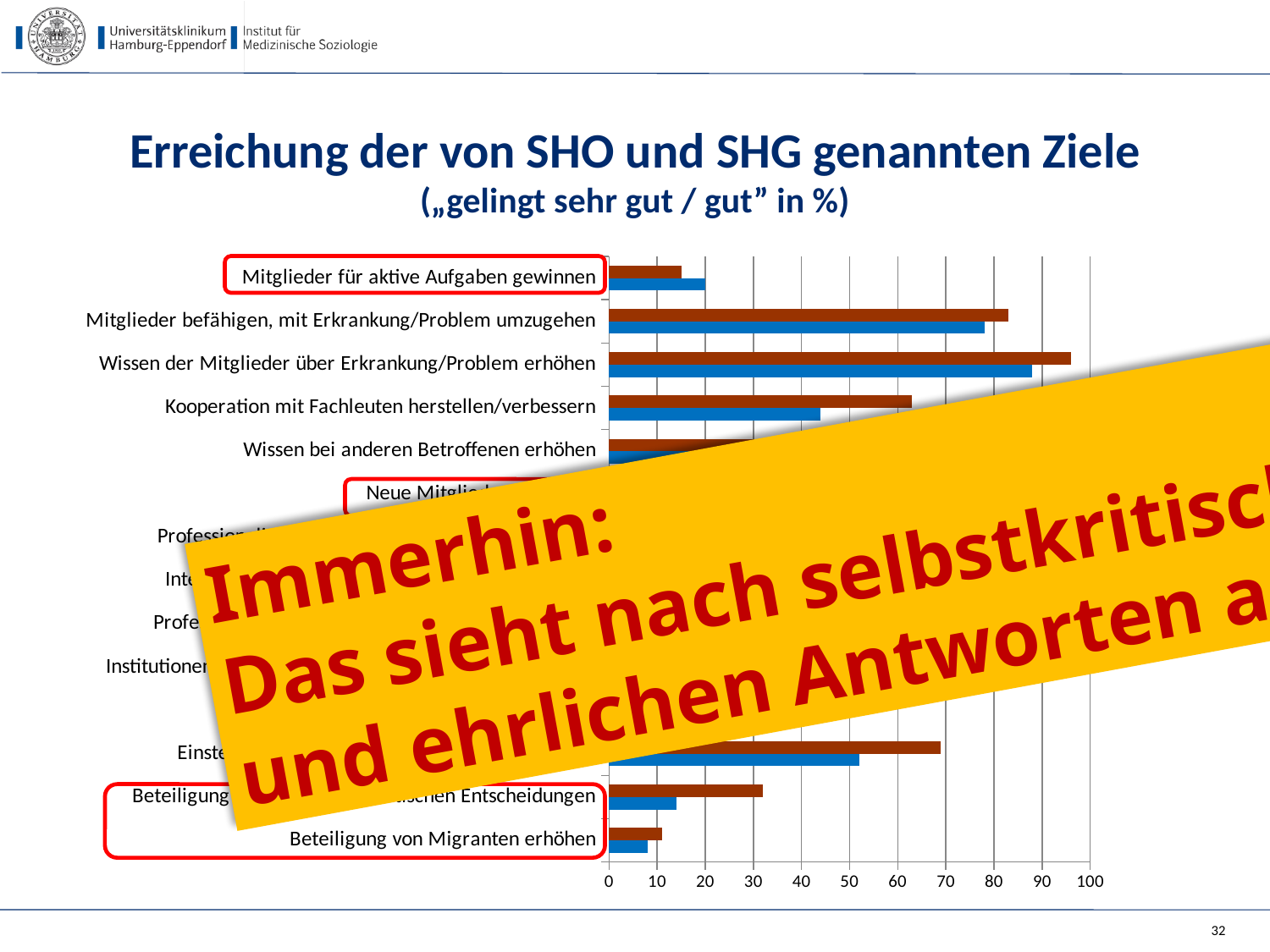
For "Kooperation mit Fachleuten herstellen/verbessern", which bar is longer, the brown one or the blue one? the brown one Which has the larger brown bar: "Wissen der Mitglieder über Erkrankung/Problem erhöhen" or "Kooperation mit Fachleuten herstellen/verbessern"? Wissen der Mitglieder über Erkrankung/Problem erhöhen What is the title of the chart on the slide? Erreichung der von SHO und SHG genannten Ziele Which has the larger blue bar: "Mitglieder befähigen, mit Erkrankung/Problem umzugehen" or "Mitglieder für aktive Aufgaben gewinnen"? Mitglieder befähigen, mit Erkrankung/Problem umzugehen What kind of chart is shown on the slide? bar chart What is the highest value shown on the x axis of the chart? 100 Is the brown bar for "Mitglieder befähigen, mit Erkrankung/Problem umzugehen" greater or less than 70? greater Is the blue bar for "Mitglieder für aktive Aufgaben gewinnen" greater or less than 30? less Is the brown bar for "Wissen der Mitglieder über Erkrankung/Problem erhöhen" greater or less than 90? greater